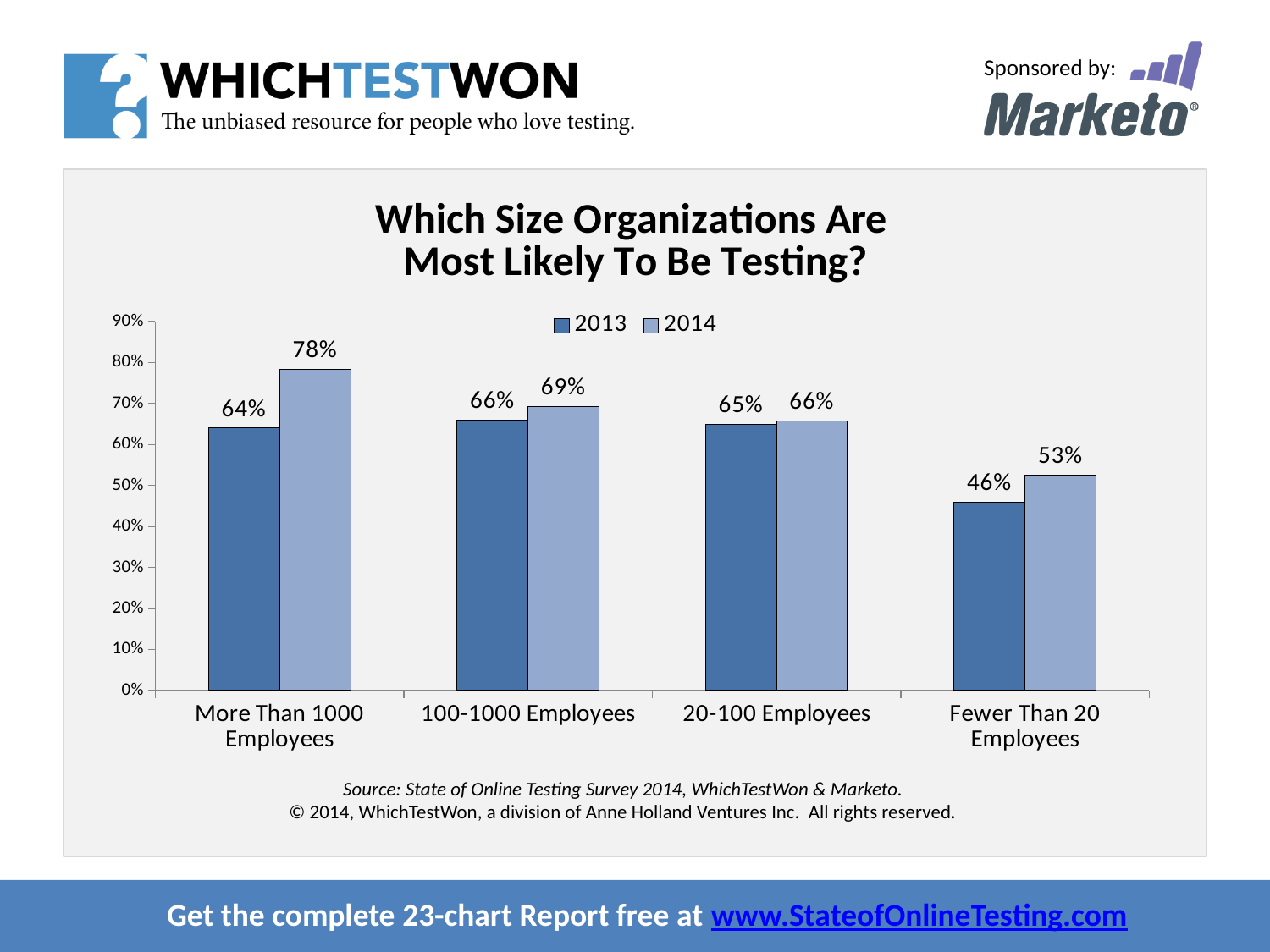
What is the 2013 value for 20-100 Employees? 65% How many series does the legend list? 2 What is the difference between the 2014 and 2013 values for Fewer Than 20 Employees? 7% Which organization size has the highest 2014 value? More Than 1000 Employees What is the 2013 value for Fewer Than 20 Employees? 46% What is the title of the chart? Which Size Organizations Are Most Likely To Be Testing? How many organization size categories are shown on the x axis? 4 What is the difference between the 2014 and 2013 values for More Than 1000 Employees? 14% Which is larger: the 2014 value for 100-1000 Employees or the 2014 value for Fewer Than 20 Employees? 100-1000 Employees What kind of chart is shown on the slide? Bar chart Which organization size has the lowest 2013 value? Fewer Than 20 Employees What is the 2014 value for More Than 1000 Employees? 78%